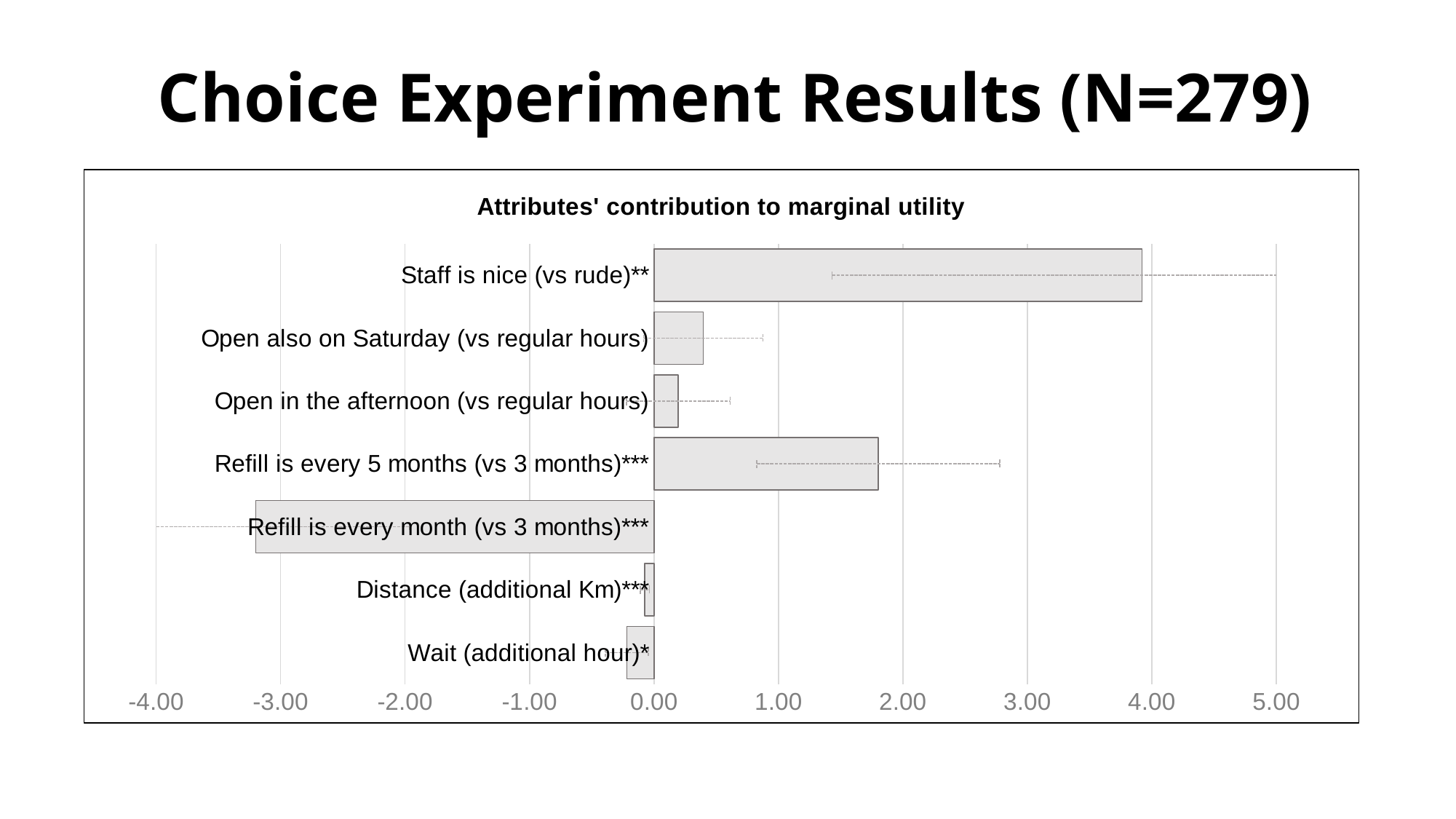
Which has a larger contribution to marginal utility: Refill is every 5 months (vs 3 months)*** or Open also on Saturday (vs regular hours)? Refill is every 5 months (vs 3 months)*** Which attribute has the lowest (most negative) contribution to marginal utility? Refill is every month (vs 3 months)*** Is the value for Refill is every 5 months (vs 3 months)*** greater or less than 1.00? greater What kind of chart is shown on the slide? Bar chart Which has a larger contribution to marginal utility: Open also on Saturday (vs regular hours) or Open in the afternoon (vs regular hours)? Open also on Saturday (vs regular hours) What is the title of the chart? Attributes' contribution to marginal utility Is the value for Staff is nice (vs rude)** greater or less than 3.00? greater Which attribute has the highest contribution to marginal utility? Staff is nice (vs rude)** Is the value for Refill is every month (vs 3 months)*** greater or less than -3.00? less What is the lowest value shown on the horizontal axis of the chart? -4.00 How many attributes (bars) are plotted in the chart? 7